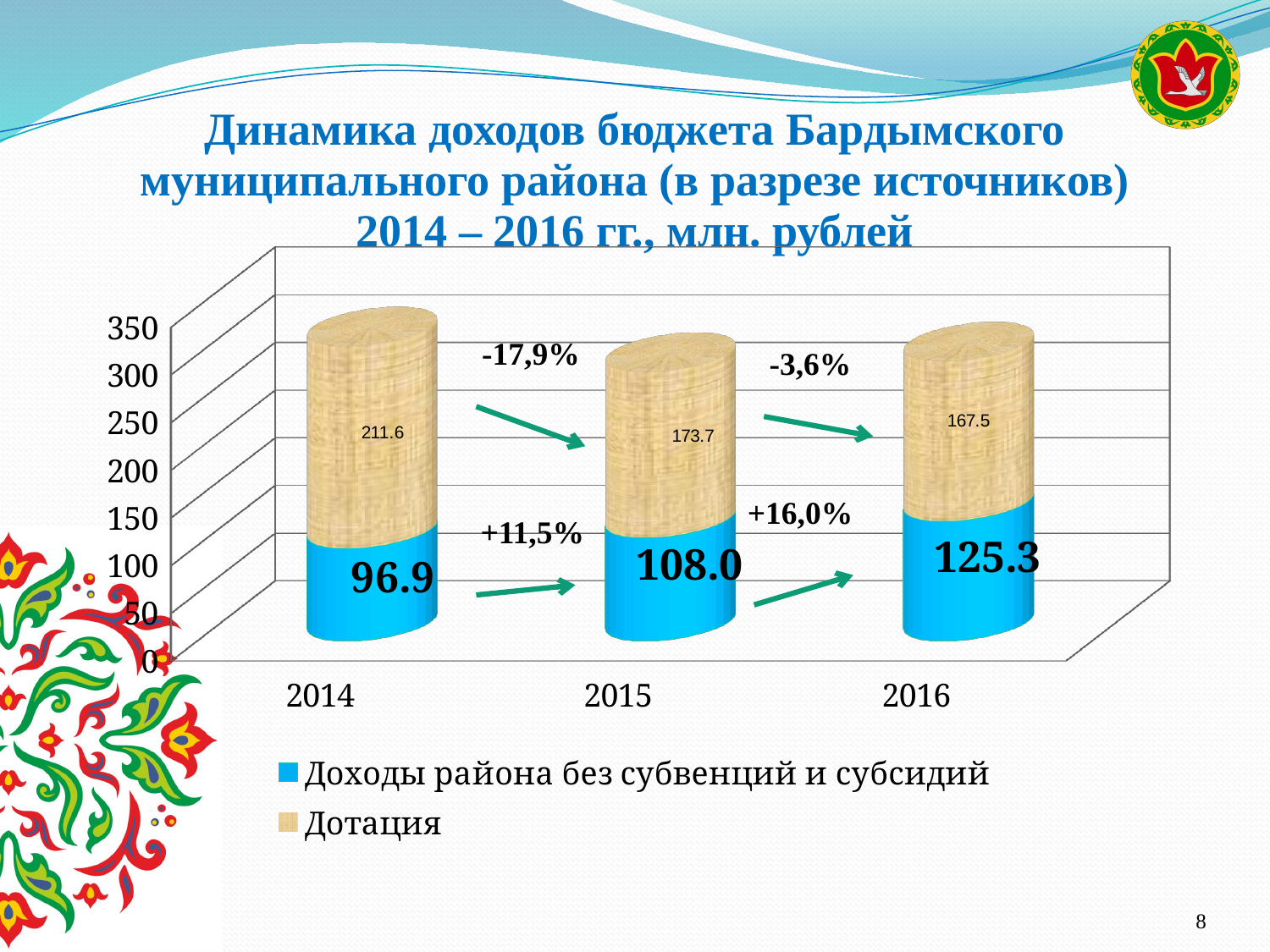
Does «Доходы района без субвенций и субсидий» rise or fall from 2014 to 2016? rise Which is larger in 2016: «Дотация» or «Доходы района без субвенций и субсидий»? Дотация How many years are shown on the x axis? 3 What is the value of «Дотация» for 2016? 167.5 What is the difference between «Дотация» in 2014 and in 2015? 37.9 What is the total of the stacked bar for 2015? 281.7 How many series does the legend list? 2 What is the value of «Доходы района без субвенций и субсидий» for 2015? 108.0 What is the value of «Доходы района без субвенций и субсидий» for 2016? 125.3 In which year is «Доходы района без субвенций и субсидий» the lowest? 2014 In which year is «Дотация» the highest? 2014 What is the value of «Дотация» for 2014? 211.6